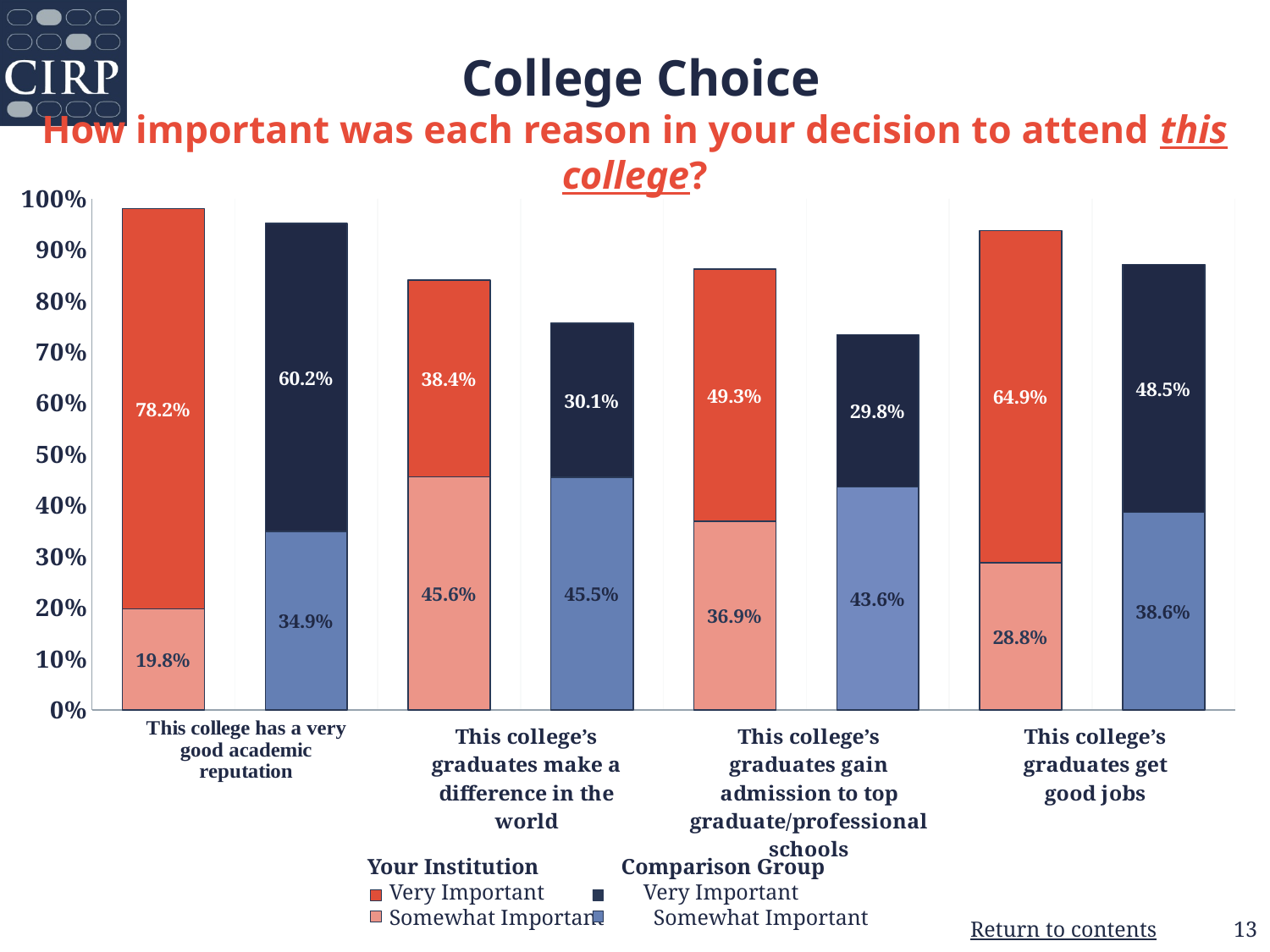
For 'This college's graduates get good jobs', which is larger: the Your Institution Very Important percentage or the Comparison Group Very Important percentage? Your Institution How many series does the legend list? 4 Which reason has the highest Very Important percentage for Your Institution? This college has a very good academic reputation How many reasons (categories) are shown on the x axis of the chart? 4 What percentage of the Comparison Group rated 'This college's graduates get good jobs' as Somewhat Important? 38.6% What percentage of Your Institution respondents rated 'This college has a very good academic reputation' as Very Important? 78.2% What is the combined Very Important and Somewhat Important percentage for Your Institution on 'This college's graduates make a difference in the world'? 84.0% Which reason has the lowest Very Important percentage for the Comparison Group? This college's graduates gain admission to top graduate/professional schools What percentage of Your Institution respondents rated 'This college's graduates gain admission to top graduate/professional schools' as Very Important? 49.3% What kind of chart is shown on the slide? Stacked bar chart What is the difference between the Your Institution and Comparison Group Very Important percentages for 'This college has a very good academic reputation'? 18.0% What is the combined Very Important and Somewhat Important percentage for the Comparison Group on 'This college's graduates get good jobs'? 87.1%